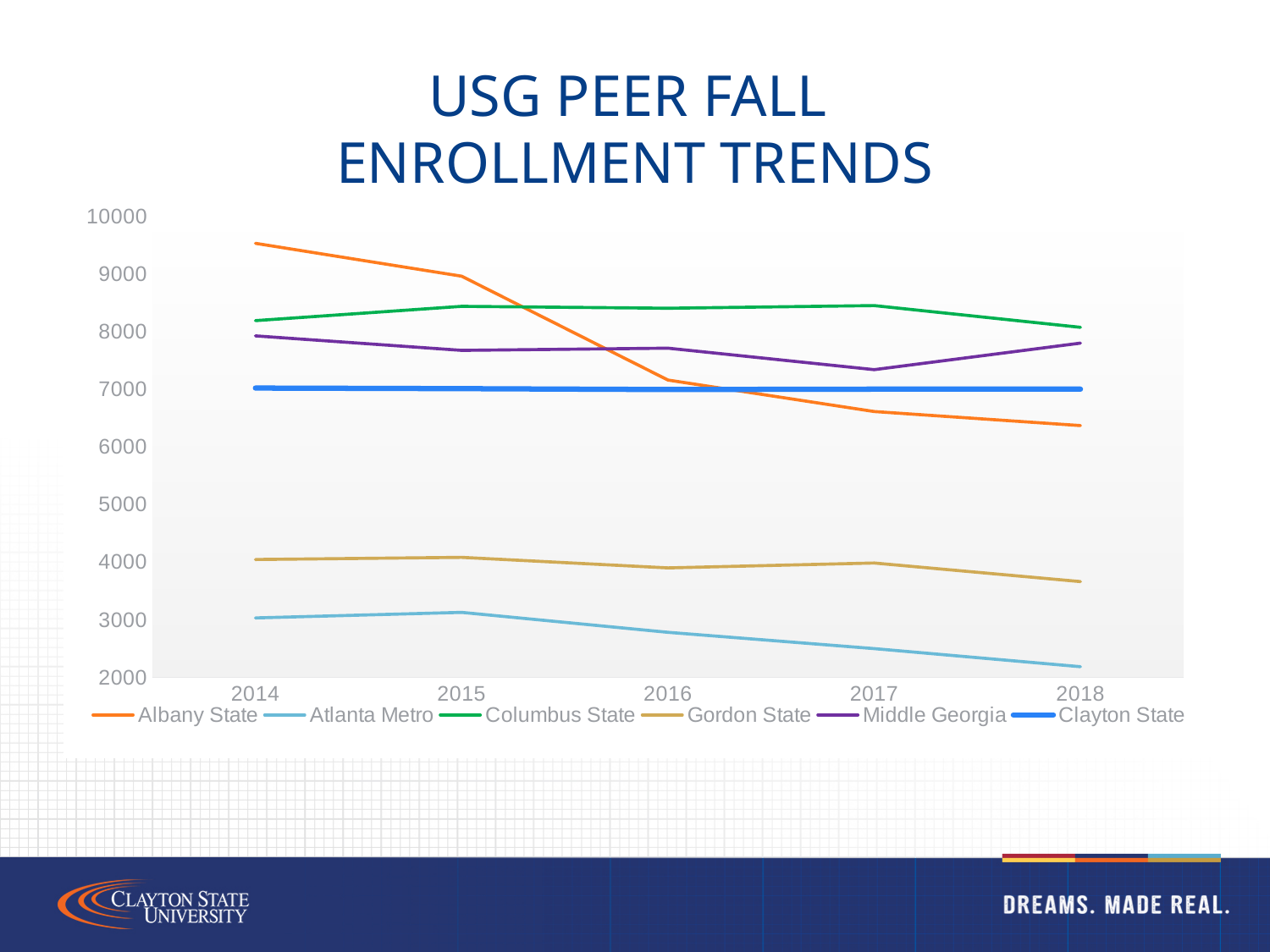
What kind of chart is shown on the slide? line chart What is the title of the chart? USG PEER FALL ENROLLMENT TRENDS Which institution has the lowest enrollment in 2018? Atlanta Metro Which institution has the highest enrollment in 2018? Columbus State Does Albany State's enrollment rise or fall from 2014 to 2018? fall Is the value for Albany State in 2014 greater or less than 9000? greater Is the value for Albany State in 2018 greater or less than 7000? less How many series does the legend list? 6 Which institution has the highest enrollment in 2014? Albany State In 2017, which is larger: Albany State or Columbus State? Columbus State How many years are shown on the x axis? 5 Is the value for Gordon State in 2018 greater or less than 4000? less